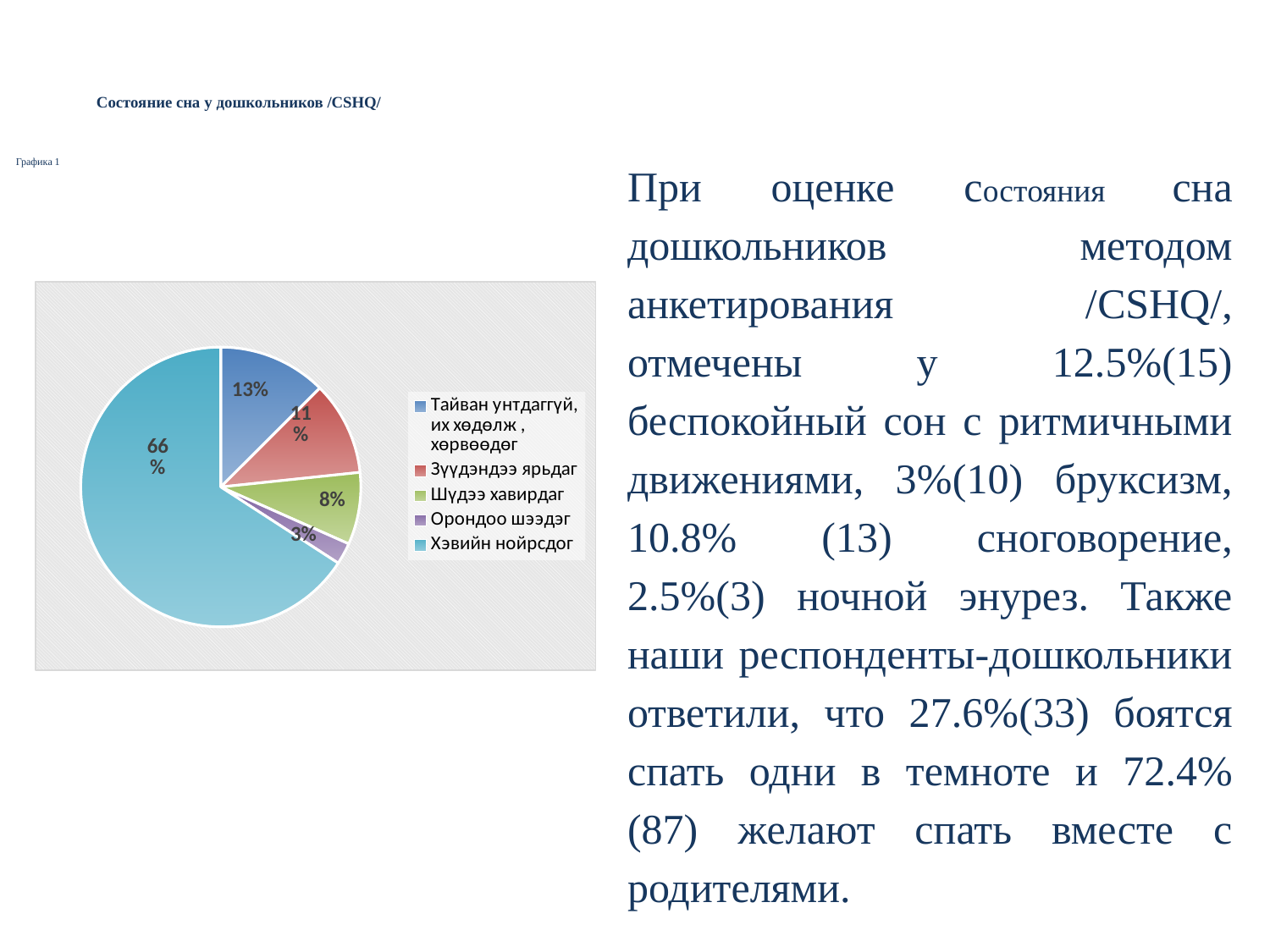
What share of the pie does the slice for Хэвийн нойрсдог represent? 66% What kind of chart is shown on the slide? pie chart What is the difference between the values for Хэвийн нойрсдог and Шүдээ хавирдаг? 58% Which category has the largest slice of the pie? Хэвийн нойрсдог What is the value shown for Зүүдэндээ ярьдаг? 11% How many slices does the pie chart have? 5 Which category has the smallest slice of the pie? Орондоо шээдэг How many entries does the legend of the pie chart list? 5 What colour is the slice for Хэвийн нойрсдог? light blue Which is larger, the slice for Зүүдэндээ ярьдаг or the slice for Шүдээ хавирдаг? Зүүдэндээ ярьдаг What is the value shown for Шүдээ хавирдаг? 8% What is the value shown for Орондоо шээдэг? 3%